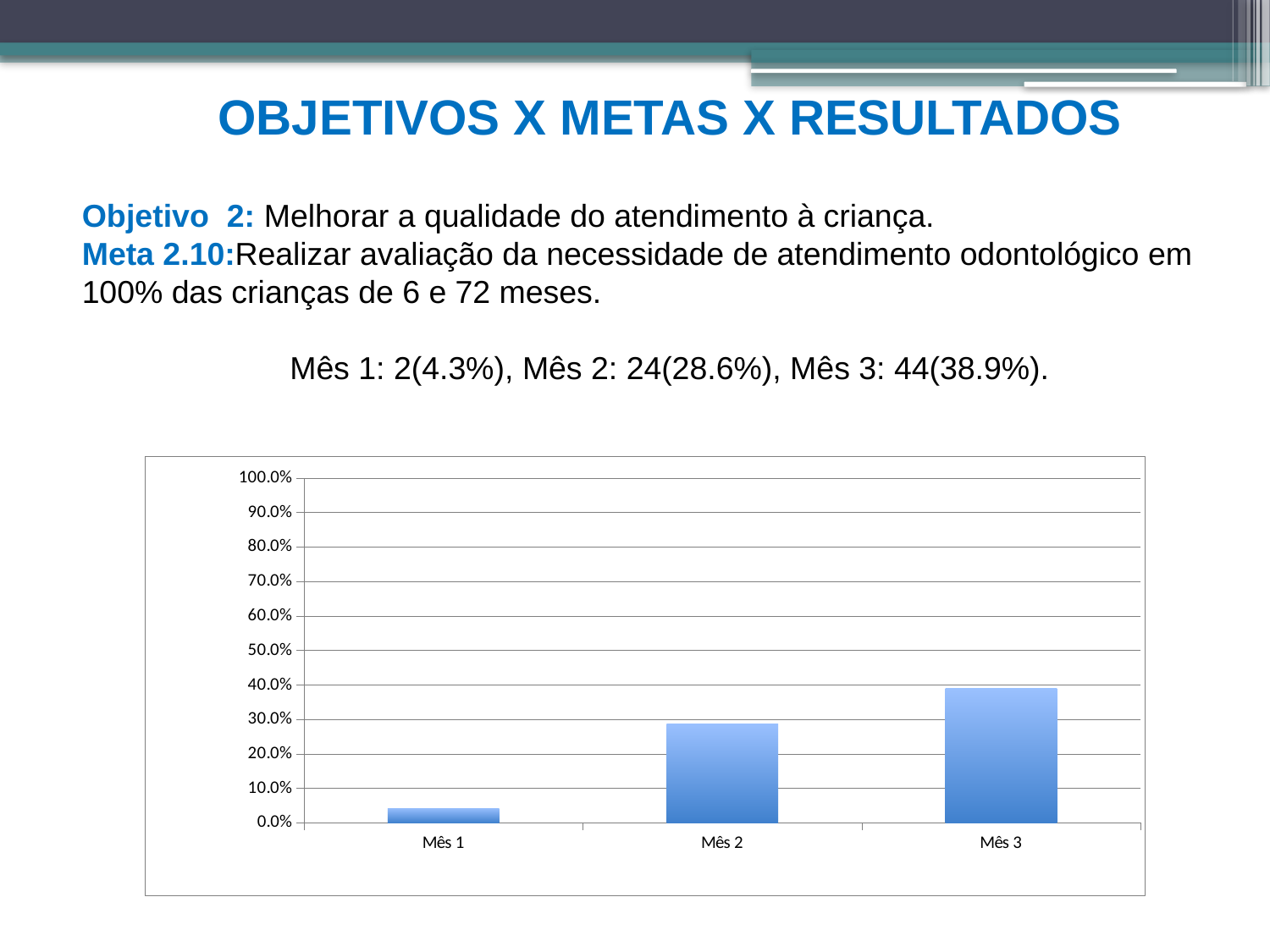
How many categories (months) are plotted on the chart? 3 What is the maximum value shown on the vertical axis of the chart? 100.0% What is the value for Mês 3 on the chart? 38.9% Which month has the lowest value on the chart? Mês 1 Is the value for Mês 3 greater or less than 30.0%? greater Do the values rise or fall from Mês 1 to Mês 3? rise What kind of chart is shown on the slide? bar chart Is the value for Mês 1 greater or less than 10.0%? less What is the value for Mês 2 on the chart? 28.6% Which month has the highest value on the chart? Mês 3 Which is larger, the value for Mês 2 or the value for Mês 3? Mês 3 What is the value for Mês 1 on the chart? 4.3%